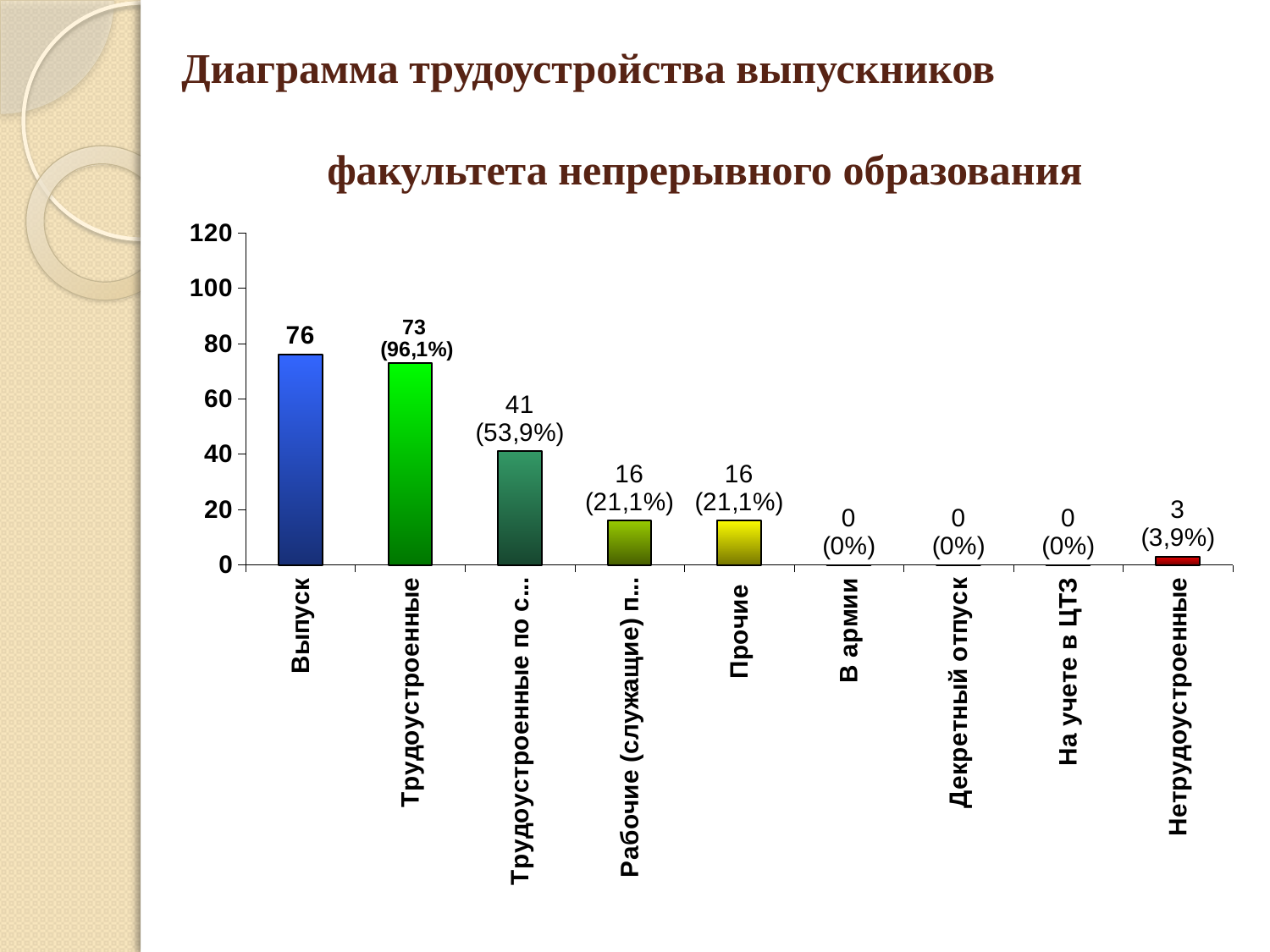
How many categories have a value of 0? 3 How many categories are shown on the x axis? 9 What is the value for Трудоустроенные? 73 What is the value for Нетрудоустроенные? 3 What kind of chart is shown on the slide? Bar chart What is the value for Выпуск? 76 Which is larger, the value for Прочие or the value for Нетрудоустроенные? Прочие What percentage is shown for Трудоустроенные? 96,1% What is the difference between the values for Выпуск and Трудоустроенные? 3 What percentage is shown for Нетрудоустроенные? 3,9% What is the value for Прочие? 16 Which category has the highest value? Выпуск